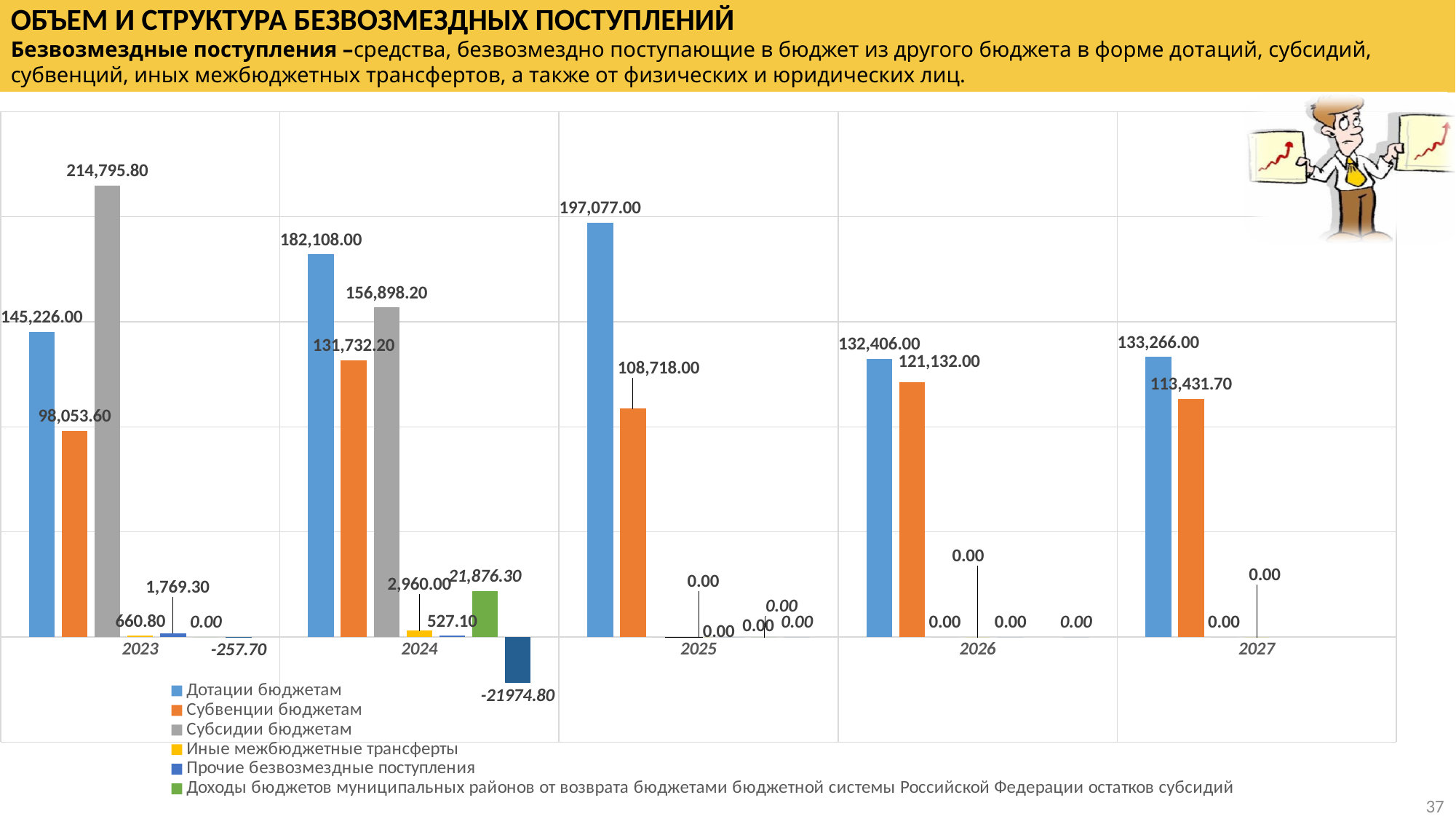
In which year is Дотации бюджетам the highest? 2025 In which year is Субвенции бюджетам the lowest? 2023 In 2023, which is larger: Субсидии бюджетам or Дотации бюджетам? Субсидии бюджетам What is the value of Доходы бюджетов муниципальных районов от возврата бюджетами бюджетной системы Российской Федерации остатков субсидий in 2024? 21,876.30 What is the value of Дотации бюджетам in 2025? 197,077.00 What is the value of Субсидии бюджетам in 2023? 214,795.80 How many series does the legend list? 6 What is the difference between Дотации бюджетам and Субвенции бюджетам in 2024? 50,375.80 How many years are shown on the x axis? 5 What kind of chart is shown on the slide? bar chart What is the value of Субвенции бюджетам in 2027? 113,431.70 What is the difference between Дотации бюджетам and Субвенции бюджетам in 2026? 11,274.00